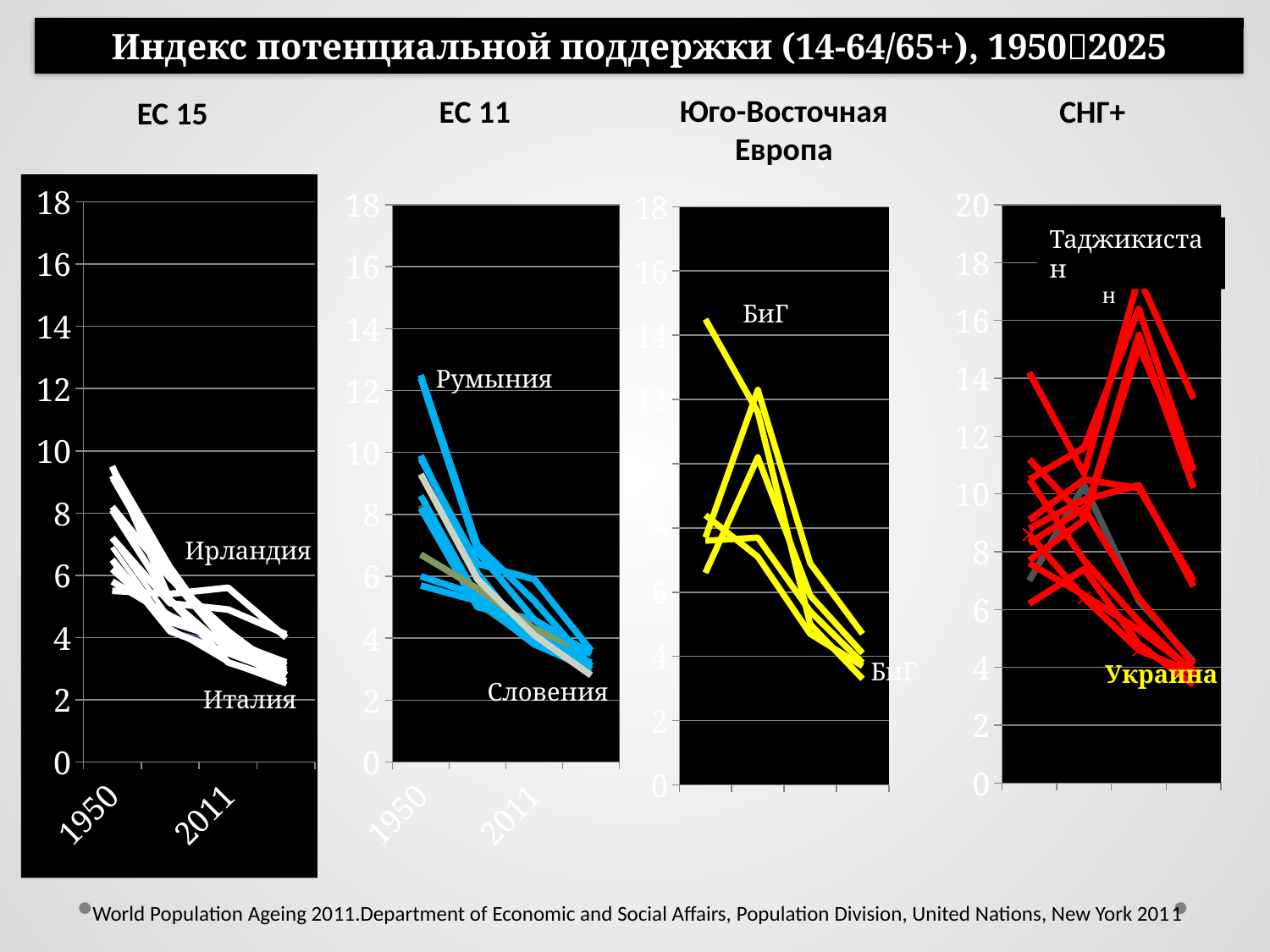
Which country is labelled at the top of the СНГ+ chart? Таджикистан What kind of chart is the ЕС 15 chart? line chart How many charts are shown on the slide? 4 In the ЕС 15 chart, do the values generally rise or fall from 1950 to 2011? fall In the ЕС 15 chart, is the final value for Италия greater or less than 4? less What is the highest value shown on the vertical axis of the СНГ+ chart? 20 In the Юго-Восточная Европа chart, is the final value for БиГ greater or less than 6? less In the ЕС 11 chart, is the 1950 value for Румыния greater or less than 10? greater In the ЕС 11 chart, does the line for Румыния rise or fall from 1950 to 2011? fall What colour are the lines in the Юго-Восточная Европа chart? yellow